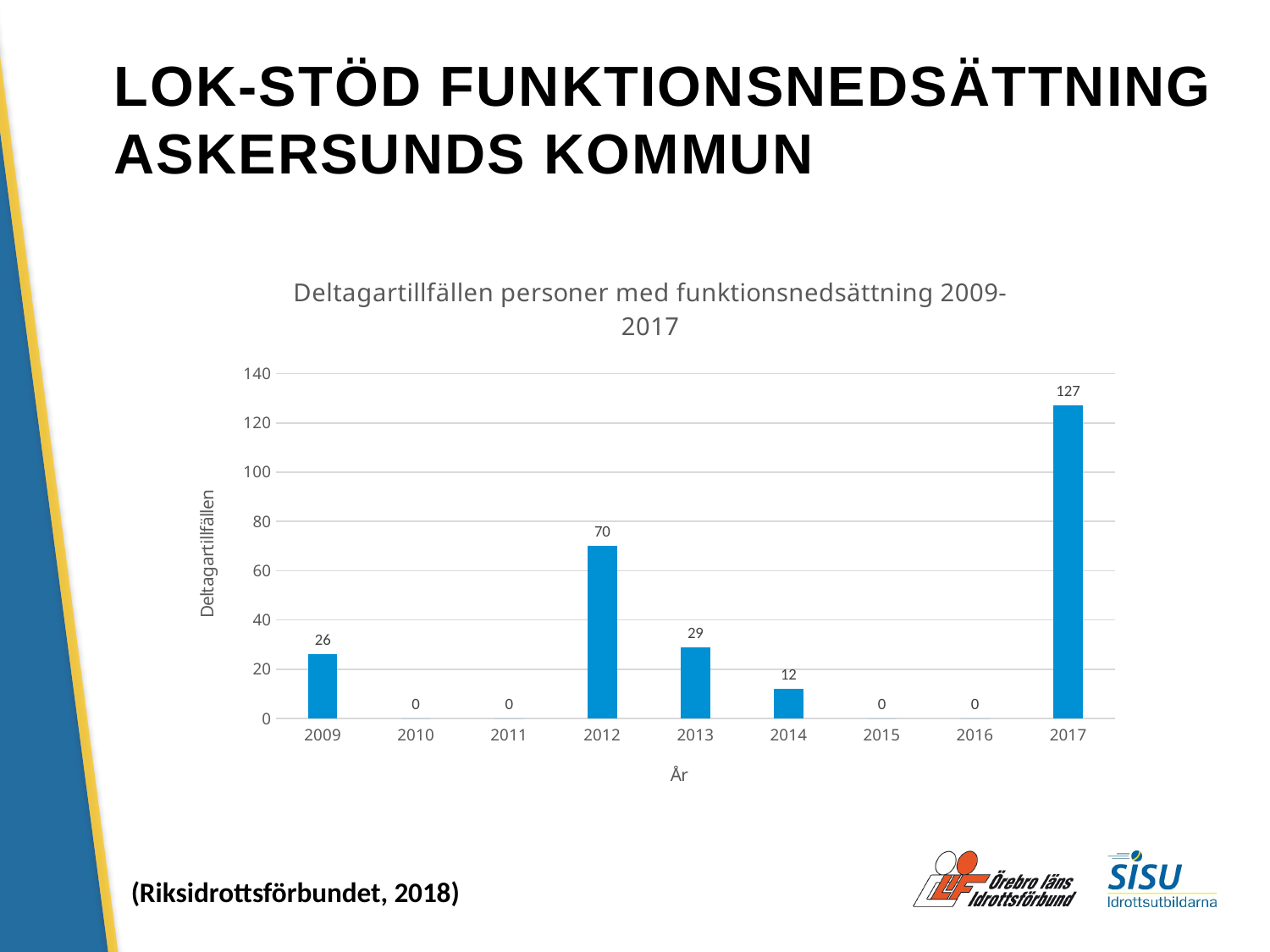
What is the label of the y axis? Deltagartillfällen What is the value for 2017? 127 What is the value for 2012? 70 How many years are shown on the x axis? 9 What is the difference between the values for 2017 and 2012? 57 What kind of chart is shown? bar chart What is the value for 2014? 12 Is the value for 2017 greater or less than 120? greater What is the difference between the values for 2013 and 2009? 3 Which year has the highest value? 2017 Which is larger, the value for 2013 or the value for 2014? 2013 What is the value for 2009? 26